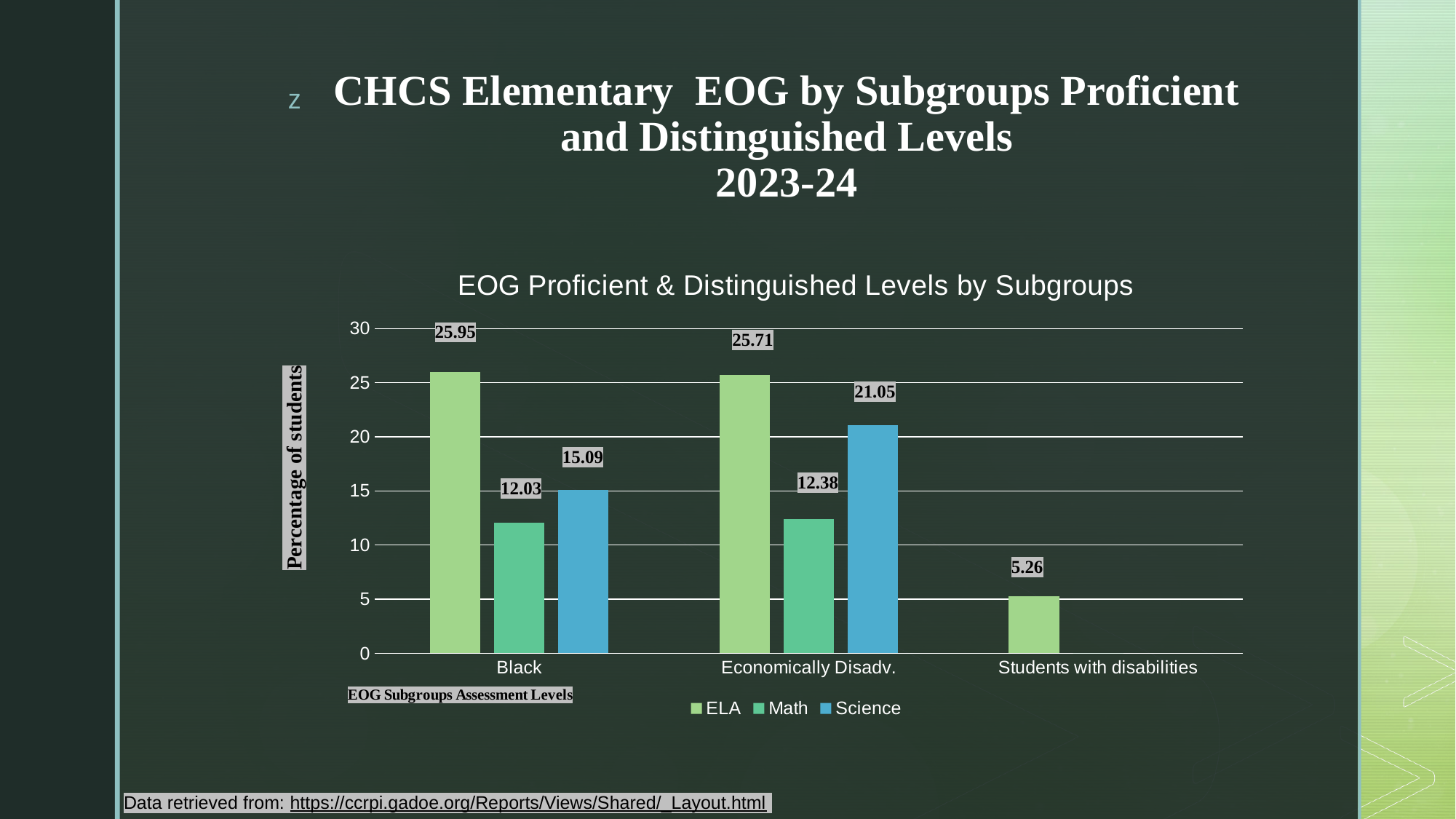
Which is larger for the Black subgroup, the Math value or the Science value? Science How many subgroups are shown on the x axis? 3 What is the Science value for the Economically Disadv. subgroup? 21.05 Which subgroup has the highest ELA value? Black How many series does the legend list? 3 What is the ELA value for the Black subgroup? 25.95 What is the Math value for the Black subgroup? 12.03 What is the ELA value for Students with disabilities? 5.26 What is the difference between the Science values for Economically Disadv. and Black? 5.96 Which subgroup has the lowest ELA value? Students with disabilities Is the Science value for the Economically Disadv. subgroup greater or less than 20? greater What kind of chart is shown on the slide? Bar chart